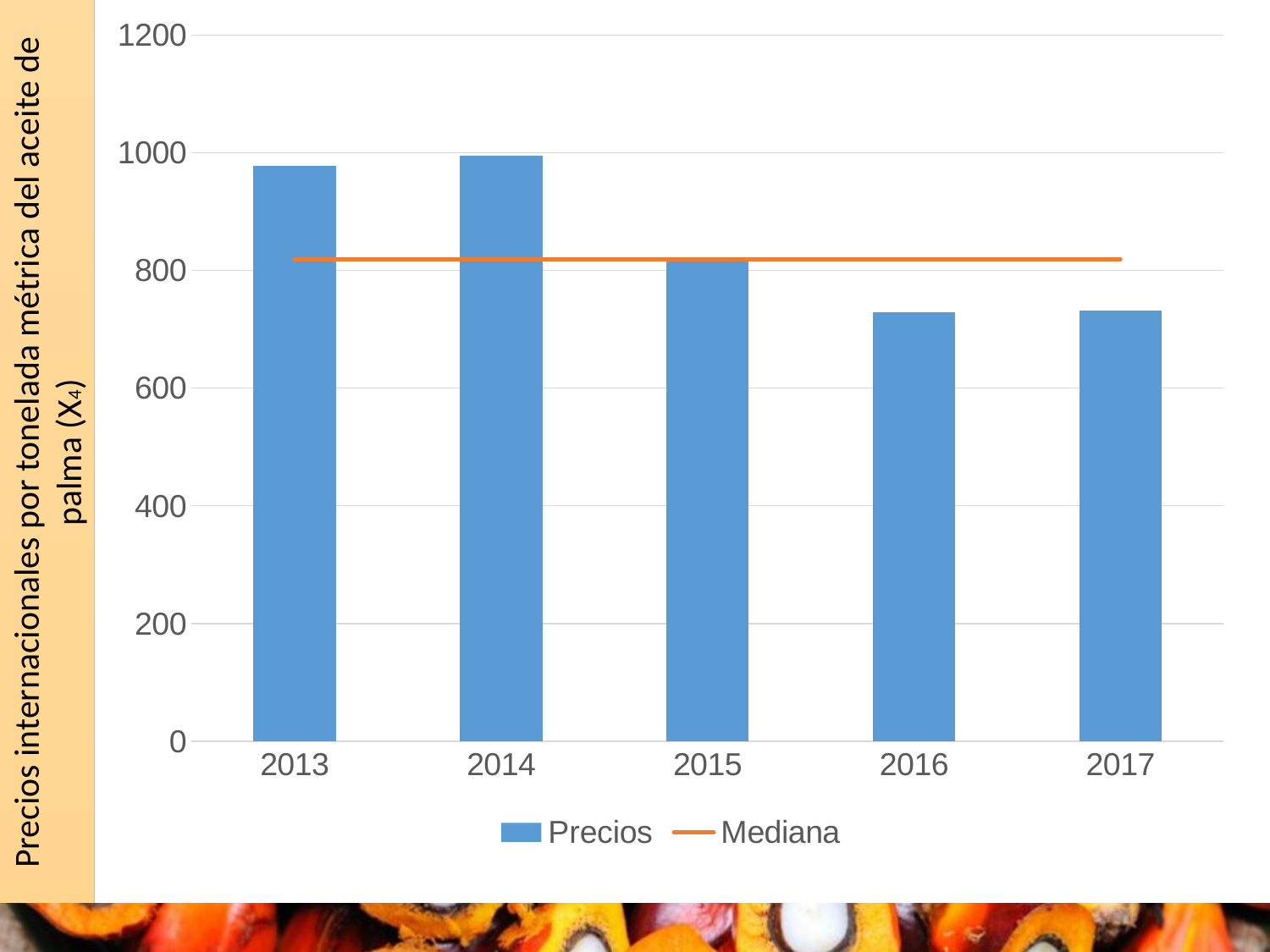
How many series does the legend list? 2 Which year has the highest Precios bar? 2014 Is the Precios value for 2013 greater or less than 1000? less Is the Precios value for 2017 greater or less than 600? greater Is the Precios value for 2016 greater or less than 800? less Which year has the larger Precios value, 2013 or 2016? 2013 How many years are shown on the x axis? 5 What kind of chart is shown on the slide? combination bar and line chart What colour is the Mediana line? orange What are the two entries listed in the legend? Precios and Mediana Do the Precios values generally rise or fall from 2013 to 2017? fall